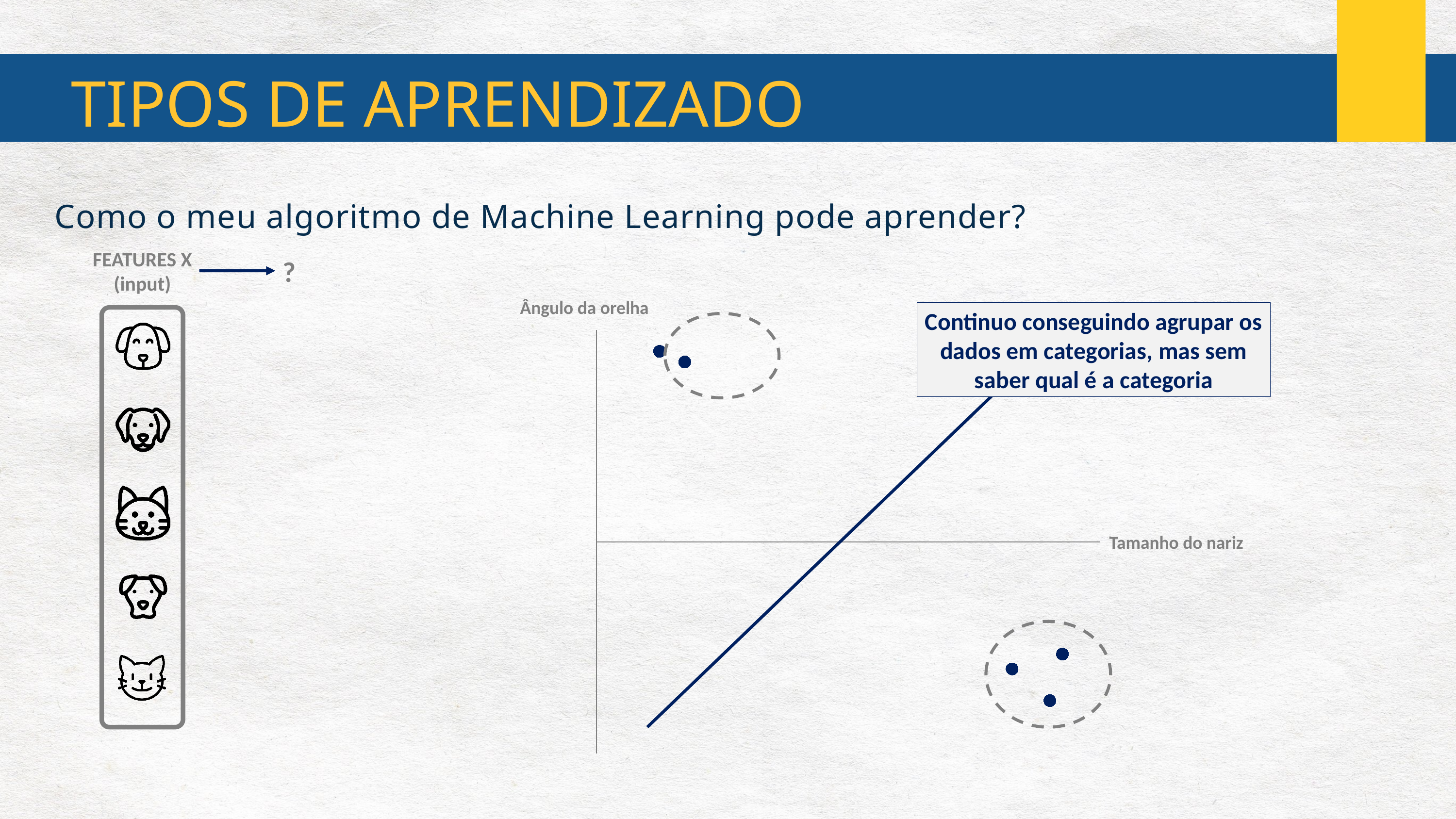
How many data points are plotted on the chart? 5 What is the label of the horizontal axis of the chart? Tamanho do nariz Which cluster contains more points, the upper-left one or the lower-right one? the lower-right one What is the label of the vertical axis of the chart? Ângulo da orelha How many points are inside the lower-right dashed cluster on the chart? 3 How many dashed-circle groups (clusters) are drawn around the points on the chart? 2 What kind of chart is shown on the slide? scatter plot